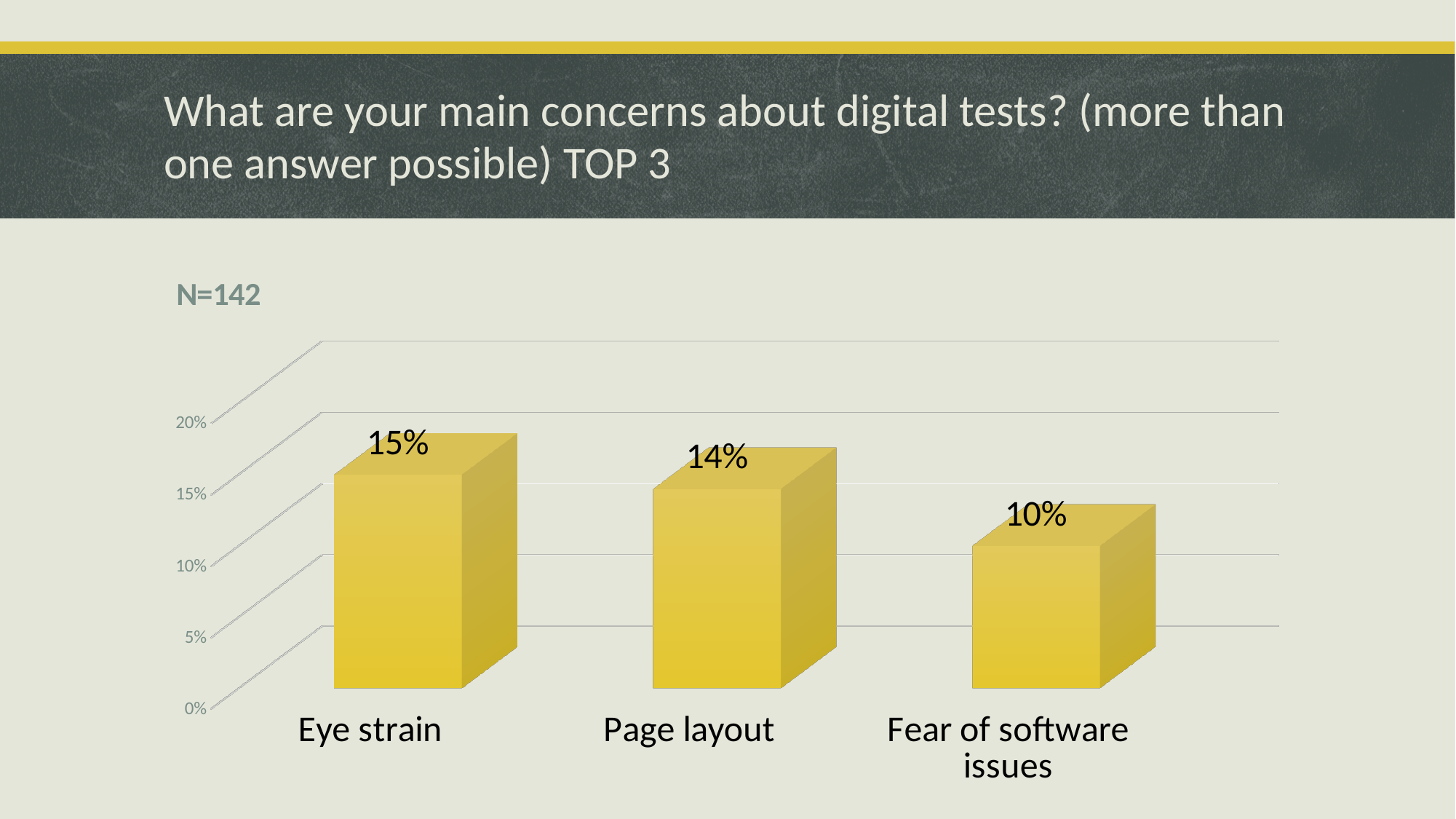
What is the difference between the values for Page layout and Fear of software issues? 4% What is the value for Page layout? 14% Which concern has the lowest value? Fear of software issues What is the value for Eye strain? 15% Is the value for Fear of software issues greater or less than 15%? less What is the difference between the values for Eye strain and Fear of software issues? 5% Which concern has the highest value? Eye strain What is the value for Fear of software issues? 10% How many categories are shown in the chart? 3 What kind of chart is shown on the slide? bar chart What sample size (N) is stated above the chart? N=142 Which is larger, the value for Page layout or the value for Fear of software issues? Page layout